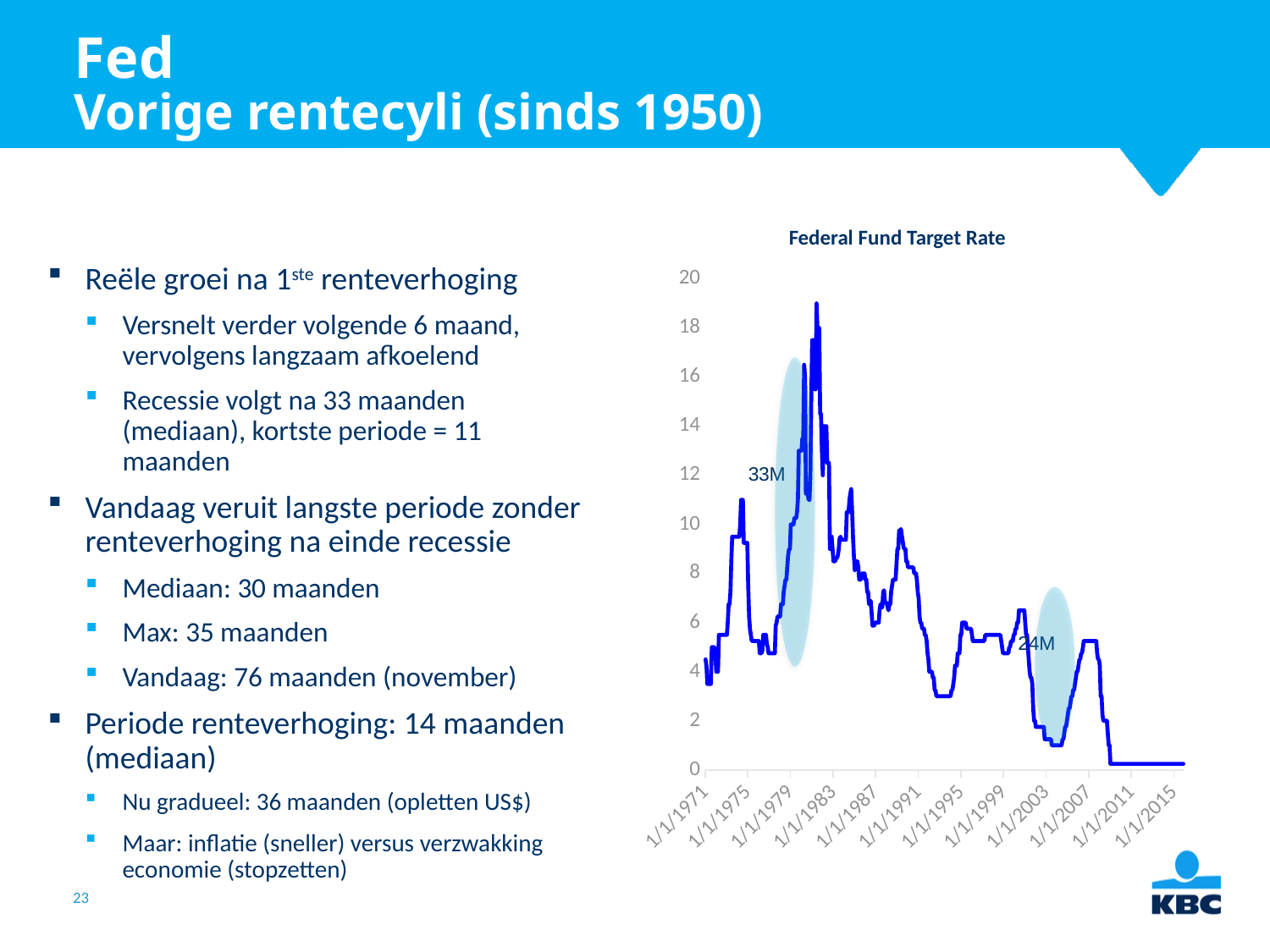
Does the Federal Fund Target Rate generally rise or fall between 1/1/1983 and 1/1/2015? fall What kind of chart is shown on the slide? line chart What is the highest value shown on the chart's vertical axis? 20 How many date labels are shown on the x axis of the chart? 12 Is the Federal Fund Target Rate at 1/1/2015 greater or less than 2? less Is the Federal Fund Target Rate at 1/1/1979 greater or less than 8? greater Is the Federal Fund Target Rate at 1/1/2011 greater or less than 2? less What is the title of the chart? Federal Fund Target Rate Which of the two values is larger: the Federal Fund Target Rate at 1/1/1983 or at 1/1/2015? 1/1/1983